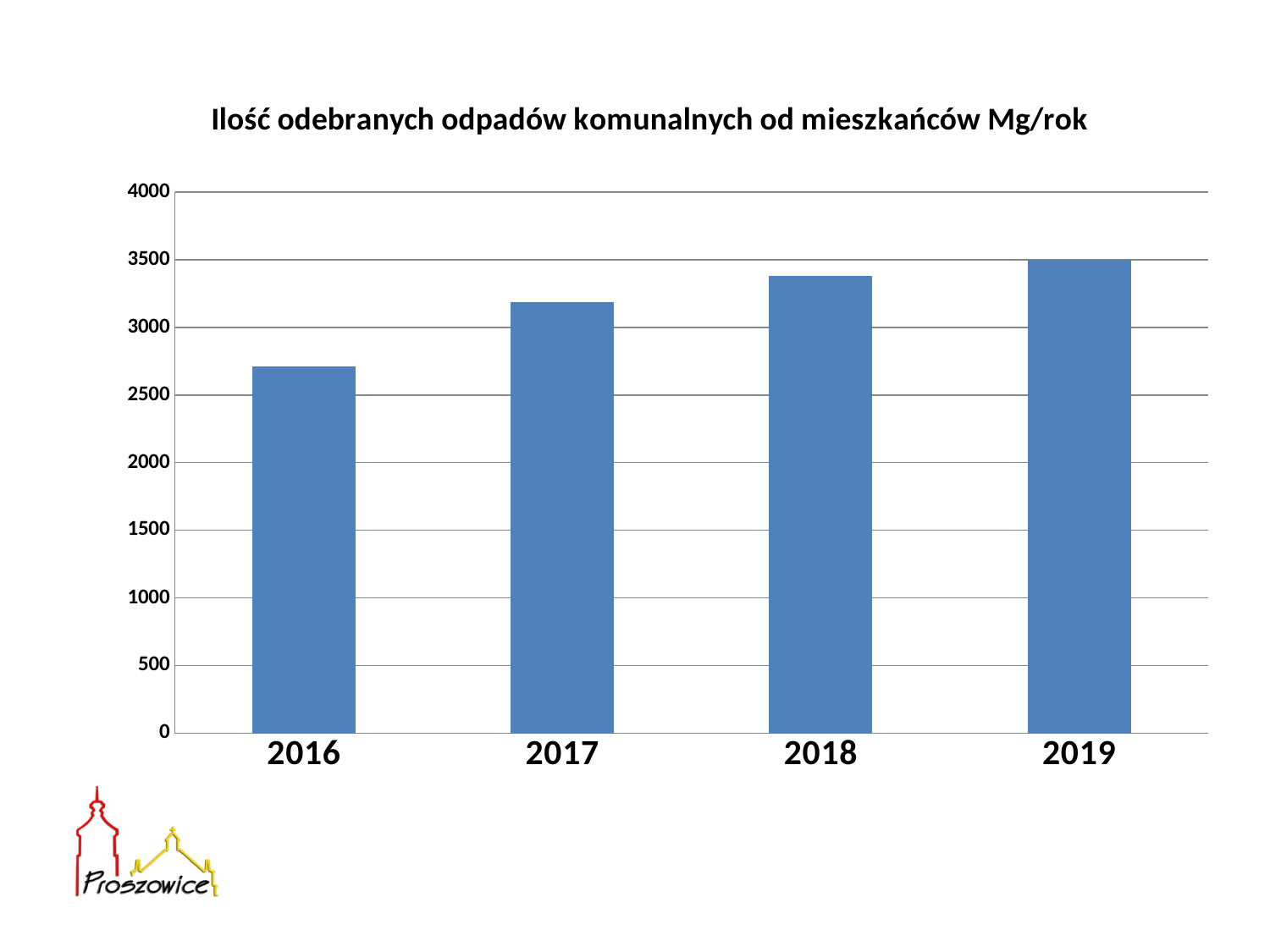
Which year has the lowest value in the chart? 2016 What kind of chart is shown on the slide? bar chart Do the values rise or fall from 2016 to 2019? rise What is the title of the chart? Ilość odebranych odpadów komunalnych od mieszkańców Mg/rok Is the value for 2017 greater or less than 3000? greater Is the value for 2016 greater or less than 3000? less Which year has the larger value, 2016 or 2017? 2017 Which year has the larger value, 2017 or 2018? 2018 Is the value for 2016 greater or less than 2500? greater Which year has the highest value in the chart? 2019 How many years are shown on the x axis of the chart? 4